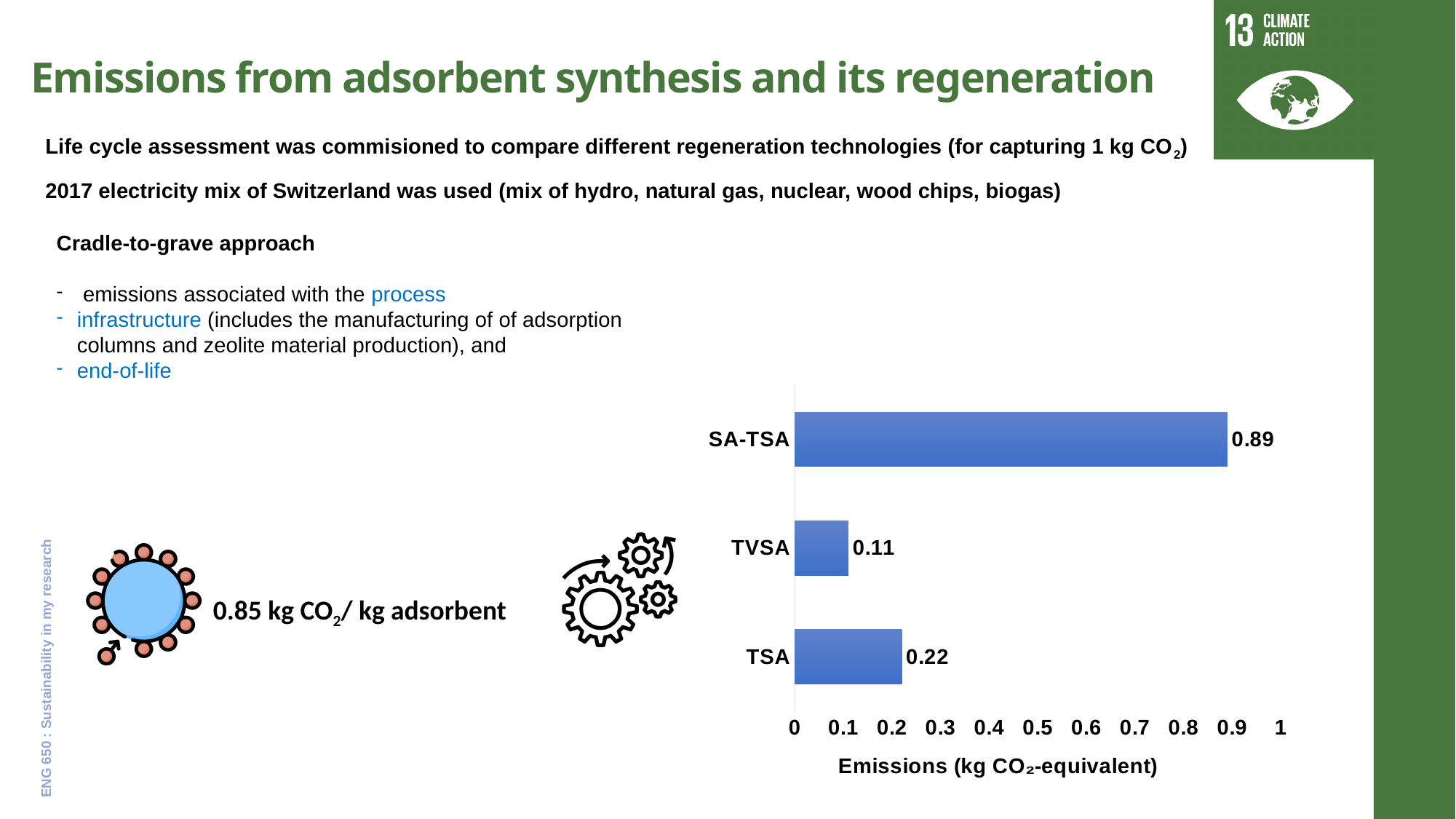
Which regeneration technology has the lowest emissions? TVSA Which has higher emissions, TSA or TVSA? TSA What is the label of the horizontal axis of the chart? Emissions (kg CO₂-equivalent) What is the difference in emissions between SA-TSA and TSA? 0.67 Which regeneration technology has the highest emissions? SA-TSA What is the difference in emissions between TSA and TVSA? 0.11 Is the emissions value for SA-TSA greater or less than 0.5? greater How many regeneration technologies are shown in the chart? 3 What kind of chart is shown on the slide? bar chart What is the emissions value for SA-TSA? 0.89 What is the emissions value for TVSA? 0.11 What is the emissions value for TSA? 0.22